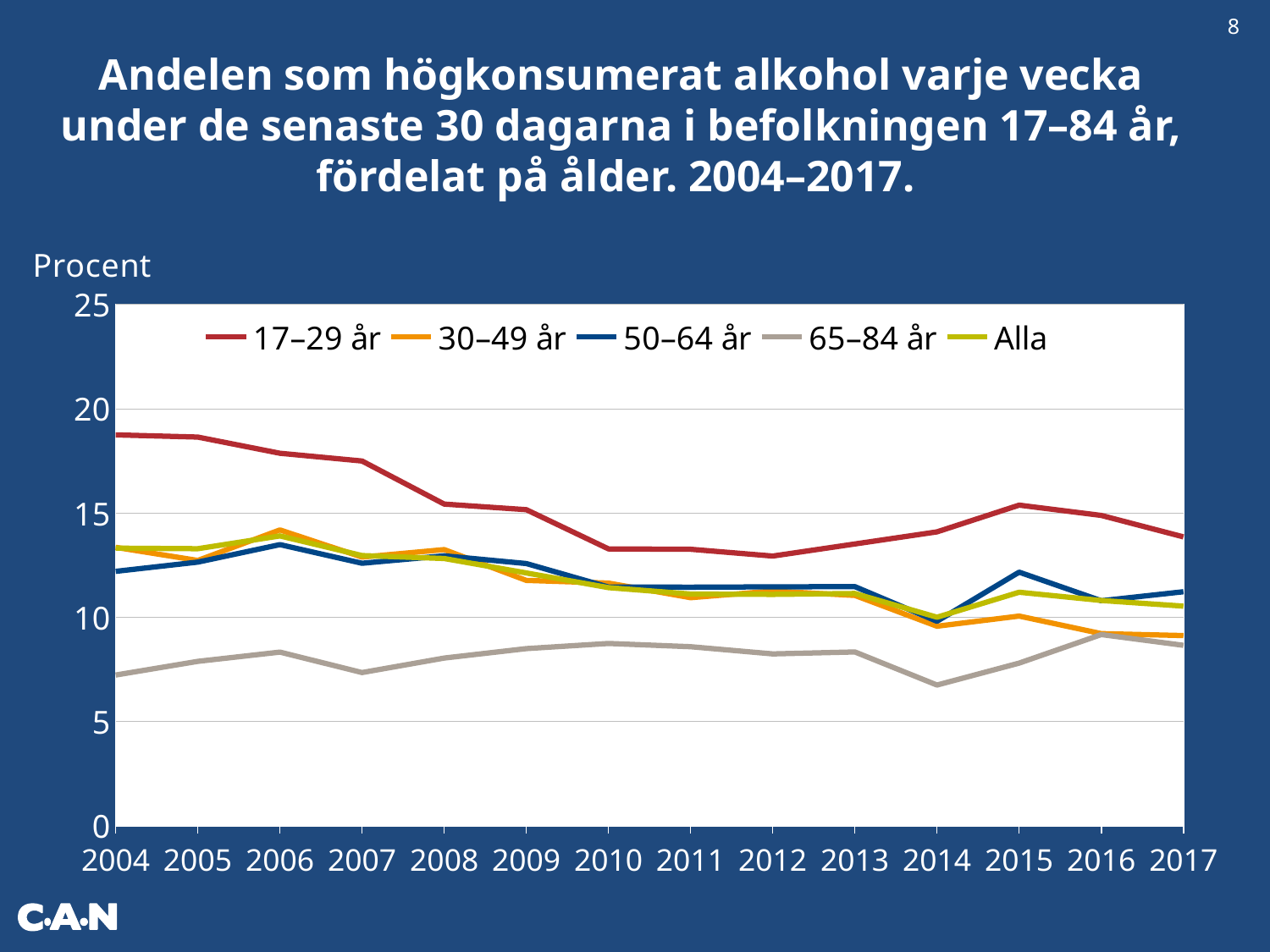
Which is larger for 65–84 år: the value in 2014 or the value in 2016? 2016 How many years are shown along the x axis? 14 Is the value for 50–64 år in 2015 greater or less than 10? greater Is the value for 17–29 år in 2004 greater or less than 15? greater What label is shown on the y axis of the chart? Procent Is the value for 65–84 år in 2014 greater or less than 10? less Which age group has the lowest value in 2010? 65–84 år Does the 17–29 år line rise or fall from 2004 to 2010? fall How many series does the legend list? 5 What kind of chart is shown on the slide? line chart Which age group has the highest value in 2004? 17–29 år Which is larger for 17–29 år: the value in 2004 or the value in 2017? 2004